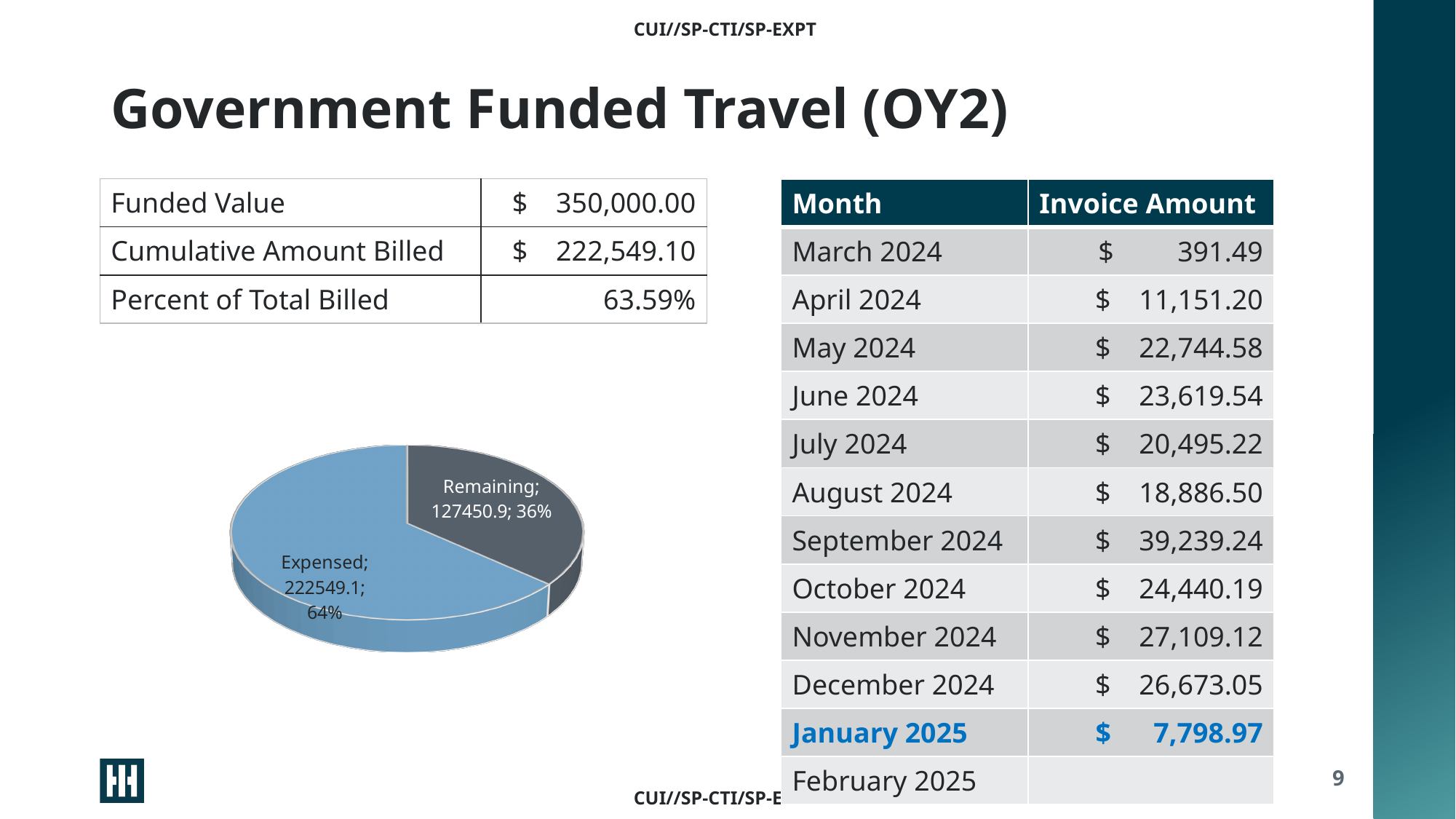
What share of the pie does the Remaining slice represent? 36% Which slice of the pie chart is the largest? Expensed What is the total of the two slice values in the pie chart? 350000 What colour is the Expensed slice of the pie chart? blue What kind of chart is shown on the slide? pie chart What share of the pie does the Expensed slice represent? 64% What value is shown for the Expensed slice of the pie chart? 222549.1 What value is shown for the Remaining slice of the pie chart? 127450.9 What is the difference between the Expensed and Remaining values in the pie chart? 95098.2 Which slice of the pie chart is the smallest? Remaining Which is larger in the pie chart, Expensed or Remaining? Expensed How many slices does the pie chart have? 2